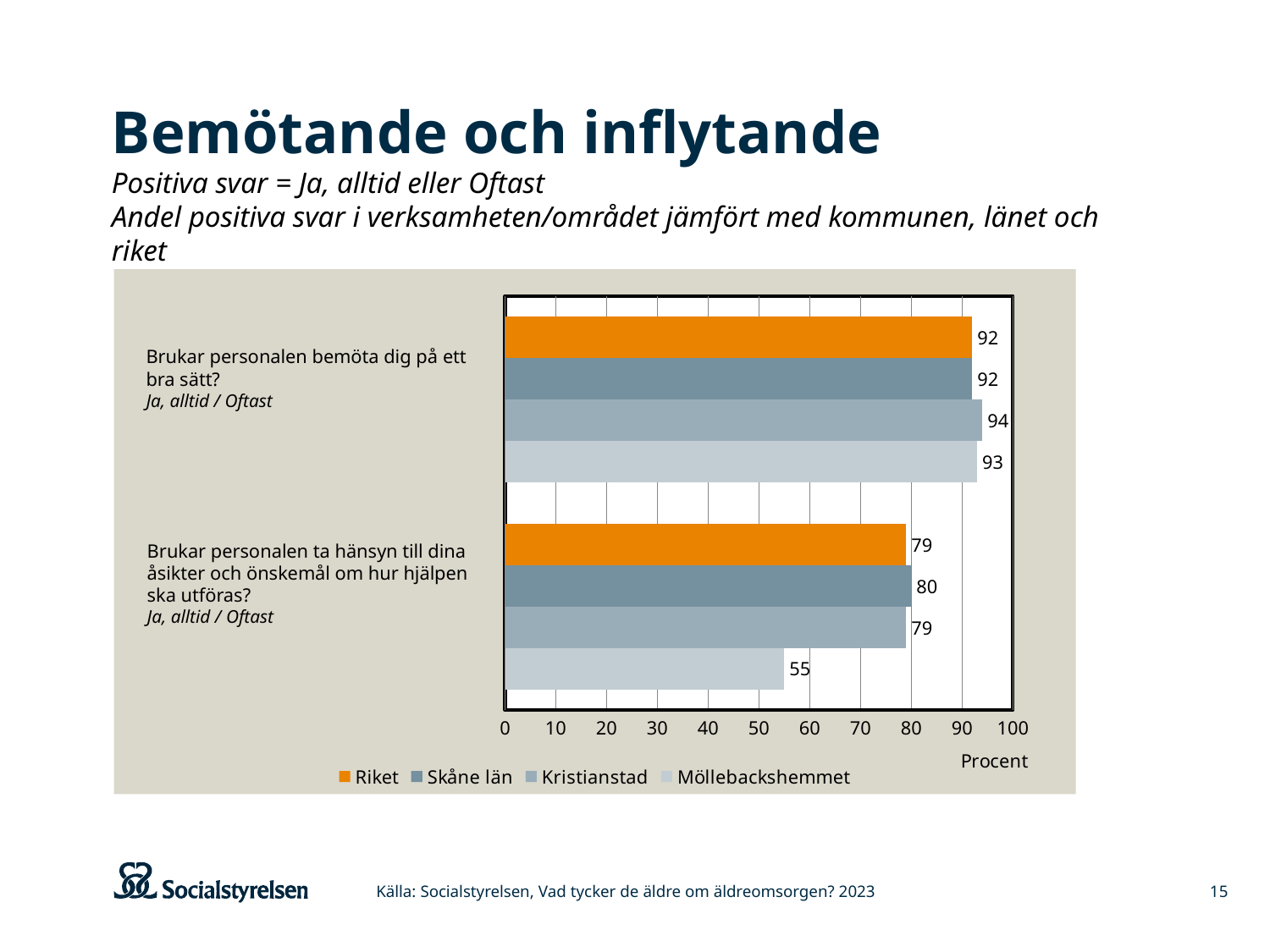
What is the value for Skåne län on the question 'Brukar personalen bemöta dig på ett bra sätt?' 92 Which series has the lowest value on the question 'Brukar personalen ta hänsyn till dina åsikter och önskemål om hur hjälpen ska utföras?' Möllebackshemmet What is the difference between the Kristianstad and Möllebackshemmet values on the question 'Brukar personalen ta hänsyn till dina åsikter och önskemål om hur hjälpen ska utföras?' 24 What is the value for Kristianstad on the question 'Brukar personalen bemöta dig på ett bra sätt?' 94 What kind of chart is shown on the slide? Bar chart Is the value for Möllebackshemmet on the question 'Brukar personalen ta hänsyn till dina åsikter och önskemål om hur hjälpen ska utföras?' greater or less than 60? less Which is larger on the question 'Brukar personalen ta hänsyn till dina åsikter och önskemål om hur hjälpen ska utföras?': Skåne län or Möllebackshemmet? Skåne län How many series does the legend list? 4 What is the value for Riket on the question 'Brukar personalen ta hänsyn till dina åsikter och önskemål om hur hjälpen ska utföras?' 79 What is the value for Möllebackshemmet on the question 'Brukar personalen ta hänsyn till dina åsikter och önskemål om hur hjälpen ska utföras?' 55 Which series has the highest value on the question 'Brukar personalen bemöta dig på ett bra sätt?' Kristianstad What unit is shown on the horizontal axis of the chart? Procent